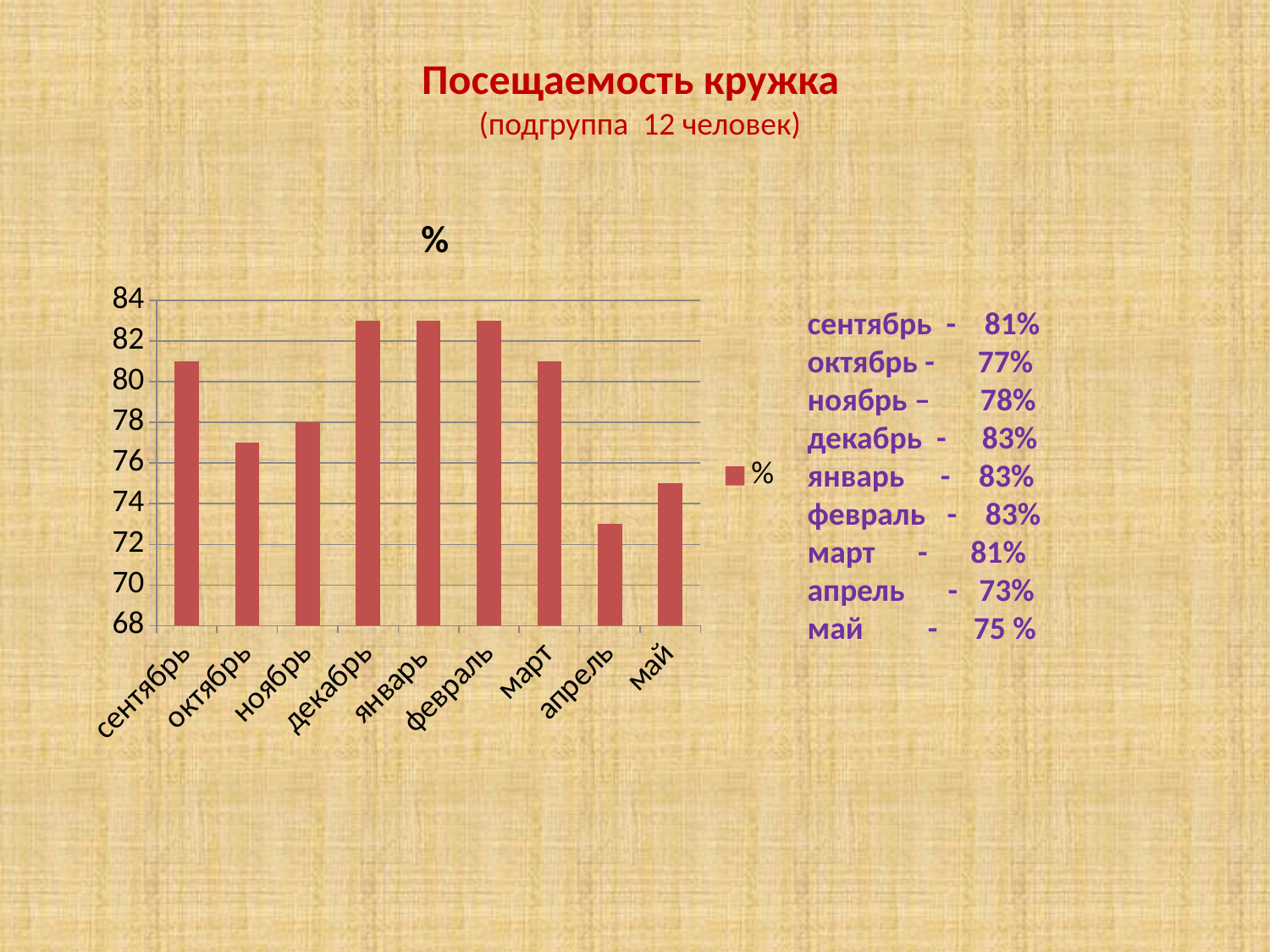
What is the attendance value for ноябрь? 78% Is the value for декабрь greater or less than 82? greater What type of chart is shown on the slide? bar chart Is the value for май greater or less than 76? less What is the attendance value for апрель? 73% How many months are shown on the x axis of the chart? 9 What is the difference between the attendance for сентябрь and апрель? 8% Which month has the lowest attendance? апрель Which is larger, the attendance for октябрь or for ноябрь? ноябрь What is the attendance value for сентябрь? 81% How many series does the legend list? 1 What is the title of the chart? %